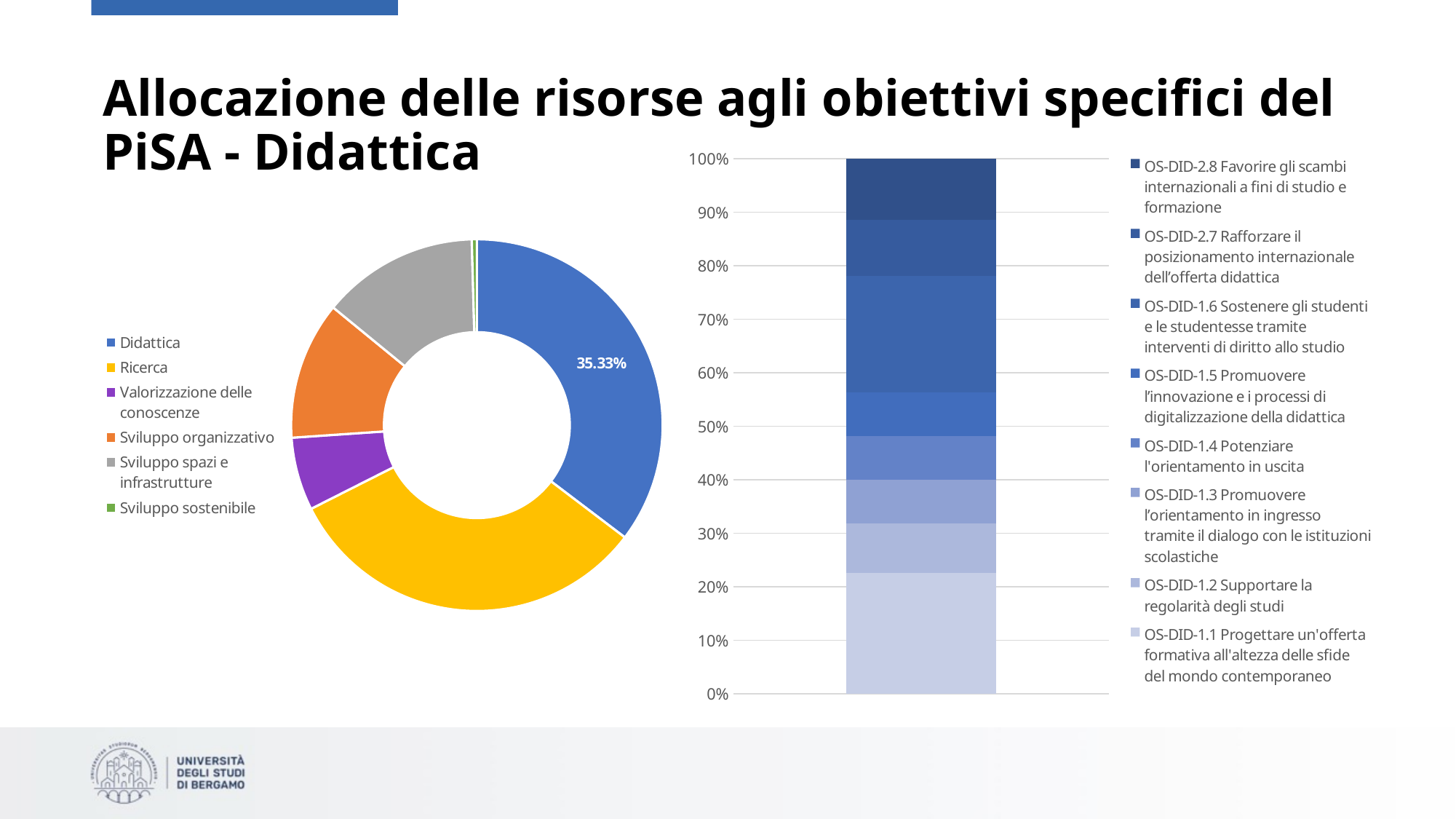
In the donut chart on the left, which category has the smallest slice? Sviluppo sostenibile In the stacked bar chart on the right, which series forms the bottom segment of the bar? OS-DID-1.1 Progettare un'offerta formativa all'altezza delle sfide del mondo contemporaneo In the donut chart on the left, which slice is larger: Sviluppo spazi e infrastrutture or Valorizzazione delle conoscenze? Sviluppo spazi e infrastrutture How many categories does the legend of the donut chart on the left list? 6 In the donut chart on the left, what percentage is shown for Didattica? 35.33% How many series does the legend of the stacked bar chart on the right list? 8 How many bars are plotted in the stacked bar chart on the right? 1 What kind of chart is the chart on the right of the slide? Stacked bar chart In the stacked bar chart on the right, what is the total height of the stacked bar? 100% What kind of chart is the chart on the left of the slide? Pie (donut) chart In the stacked bar chart on the right, is the share of the OS-DID-1.1 segment greater or less than 30%? less In the donut chart on the left, which slice is larger: Didattica or Sviluppo organizzativo? Didattica